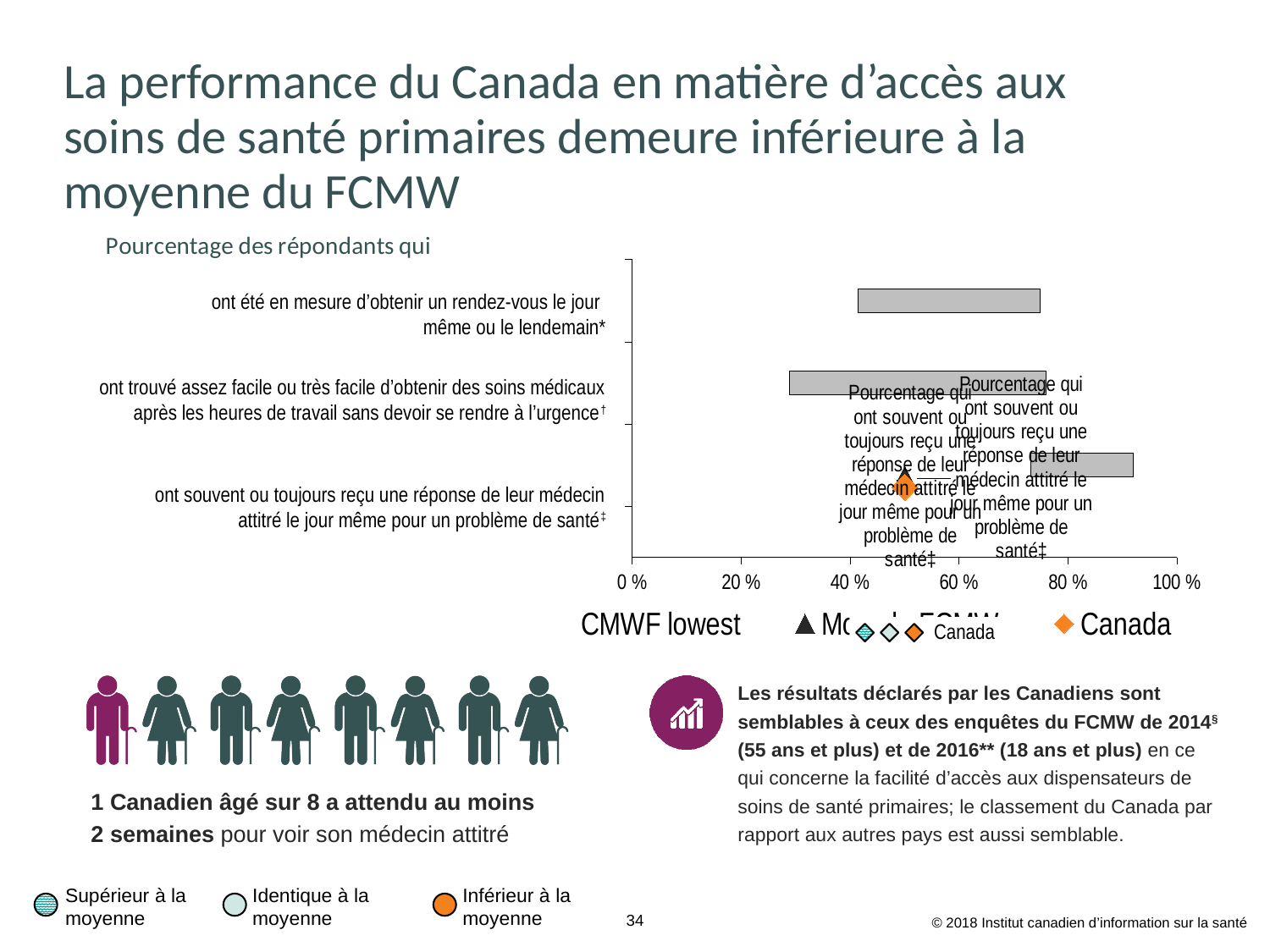
Is the Canada marker for 'ont souvent ou toujours reçu une réponse de leur médecin attitré le jour même pour un problème de santé' greater or less than 60 %? less What is the highest value shown on the horizontal axis of the chart? 100 % Is the upper end of the range bar for 'ont été en mesure d'obtenir un rendez-vous le jour même ou le lendemain' greater or less than 80 %? less Which category has the range bar that extends furthest to the right on the chart? ont souvent ou toujours reçu une réponse de leur médecin attitré le jour même pour un problème de santé Is the lower end of the range bar for 'ont trouvé assez facile ou très facile d'obtenir des soins médicaux après les heures de travail sans devoir se rendre à l'urgence' greater or less than 40 %? less How many categories (survey measures) are plotted on the chart? 3 What kind of chart is shown on the slide? bar chart Which category has the range bar that starts furthest to the left on the chart? ont trouvé assez facile ou très facile d'obtenir des soins médicaux après les heures de travail sans devoir se rendre à l'urgence How many series does the chart legend list? 3 What is the subtitle printed above the chart? Pourcentage des répondants qui